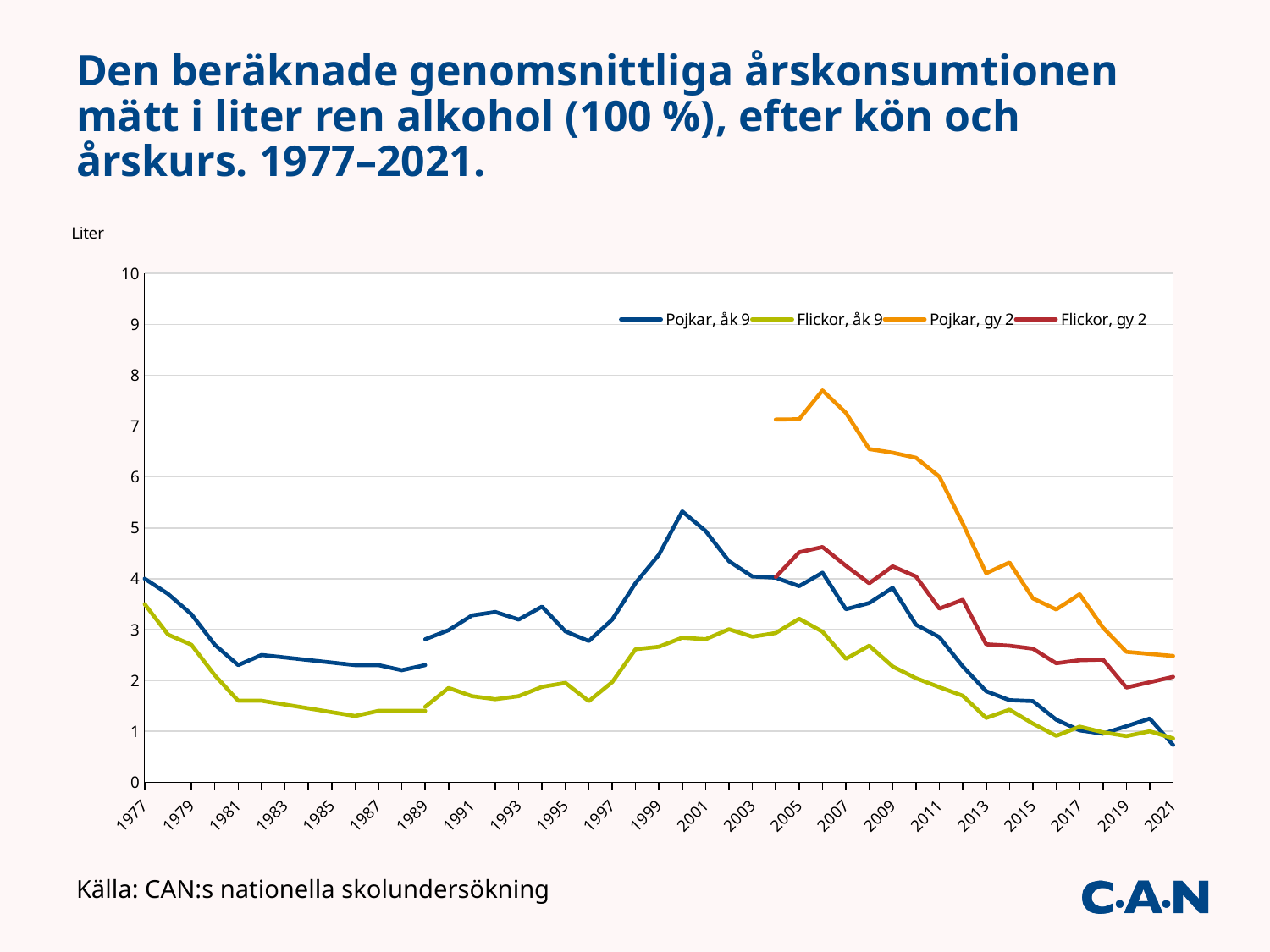
What unit label is shown above the y axis? Liter What kind of chart is shown on the slide? Line chart How many series does the legend list? 4 Is the value for Flickor, åk 9 in 1981 greater or less than 2? less Is the value for Pojkar, gy 2 in 2006 greater or less than 7? greater In 2006, which is higher: Pojkar, gy 2 or Flickor, gy 2? Pojkar, gy 2 Which series reaches the highest value anywhere on the chart? Pojkar, gy 2 Is the value for Pojkar, gy 2 in 2021 greater or less than 3? less In 1977, which is higher: Pojkar, åk 9 or Flickor, åk 9? Pojkar, åk 9 Does the Pojkar, gy 2 series rise or fall between 2006 and 2021? Fall Which series are listed in the legend? Pojkar, åk 9; Flickor, åk 9; Pojkar, gy 2; Flickor, gy 2